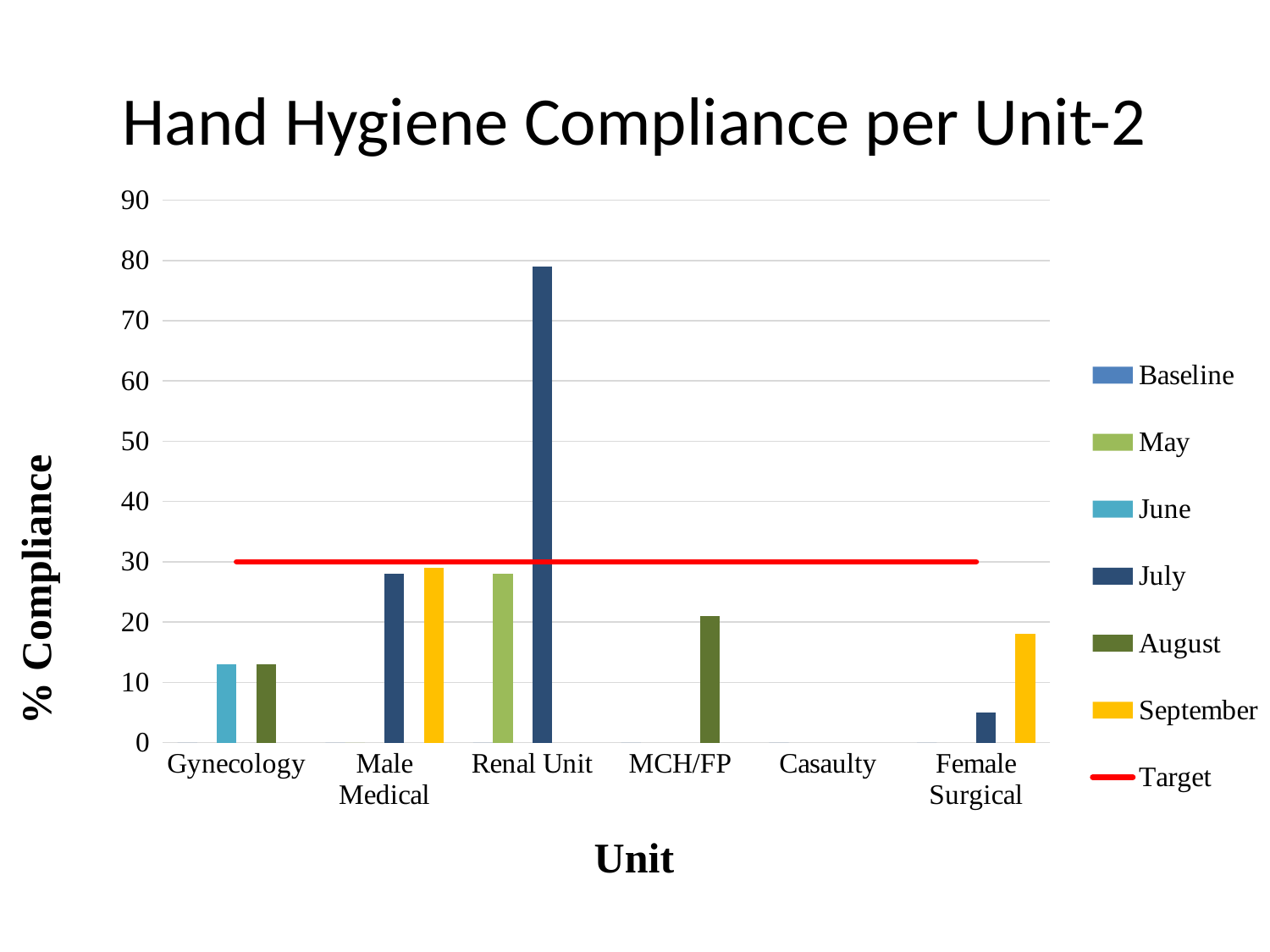
How many entries does the legend list? 7 Is the August value for MCH/FP greater or less than 30? less What is the title of the vertical axis? % Compliance Which unit has the tallest bar in the chart? Renal Unit For Female Surgical, which is larger: the July value or the September value? September How many units are listed along the x axis? 6 For Renal Unit, which is larger: the May value or the July value? July Is the July value for Renal Unit greater or less than 70? greater Is the June value for Gynecology greater or less than 20? less Which unit has no bars plotted at all? Casaulty What kind of chart is shown on the slide? bar chart At what % Compliance level is the Target line drawn? 30